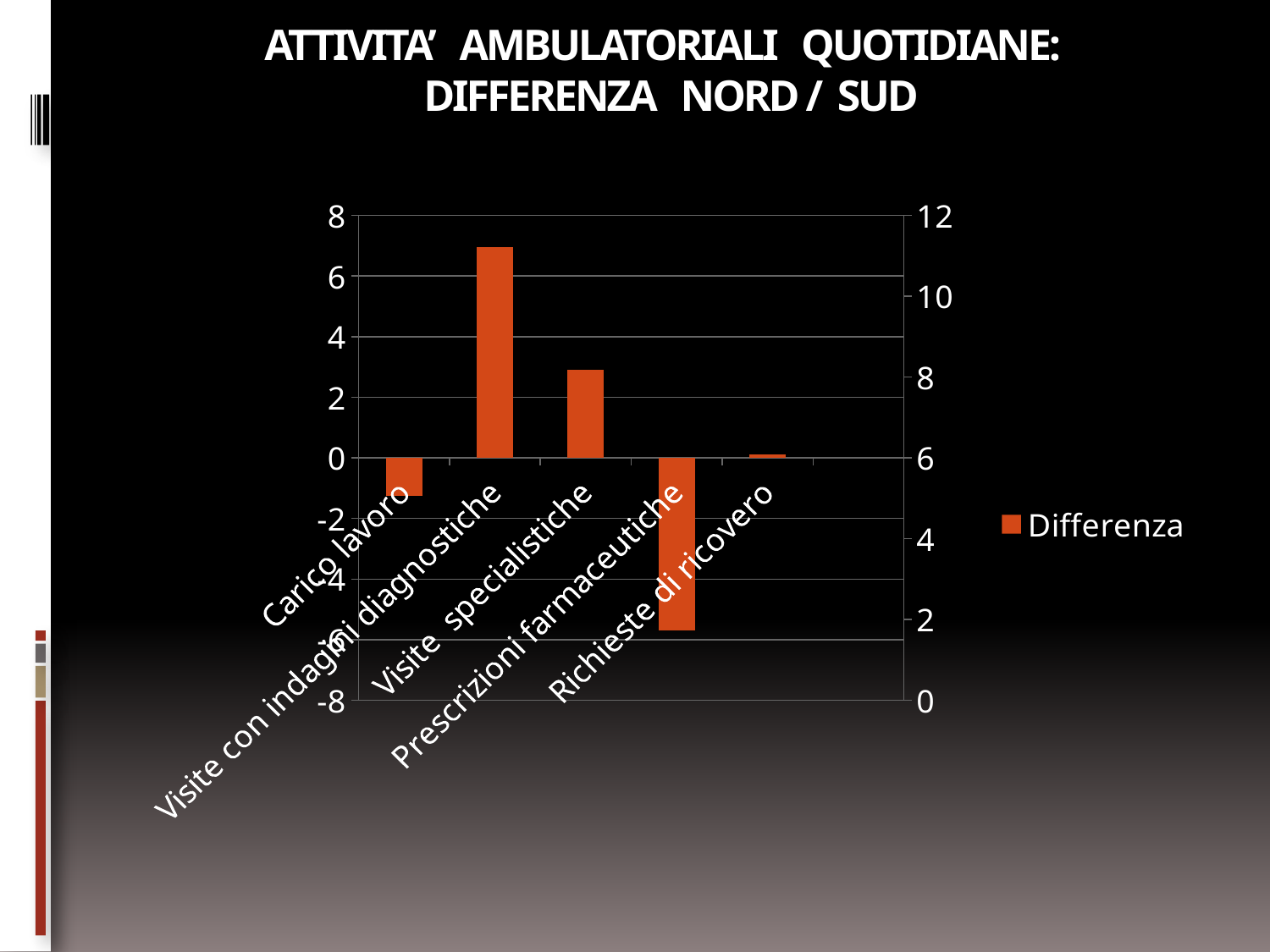
How many series does the chart's legend list? 1 Which category has the highest value in the chart? Visite con indagini diagnostiche Is the value for Visite specialistiche greater or less than 2 on the left axis? greater How many categories are plotted on the x axis of the chart? 5 How many categories in the chart have a negative value? 2 Is the value for Visite con indagini diagnostiche greater or less than 6 on the left axis? greater What is the name of the series shown in the chart's legend? Differenza What kind of chart is shown on the slide? bar chart Which is larger, the value for Carico lavoro or the value for Richieste di ricovero? Richieste di ricovero Which category has the lowest value in the chart? Prescrizioni farmaceutiche Is the value for Prescrizioni farmaceutiche greater or less than -4 on the left axis? less Which is larger, the value for Visite specialistiche or the value for Visite con indagini diagnostiche? Visite con indagini diagnostiche